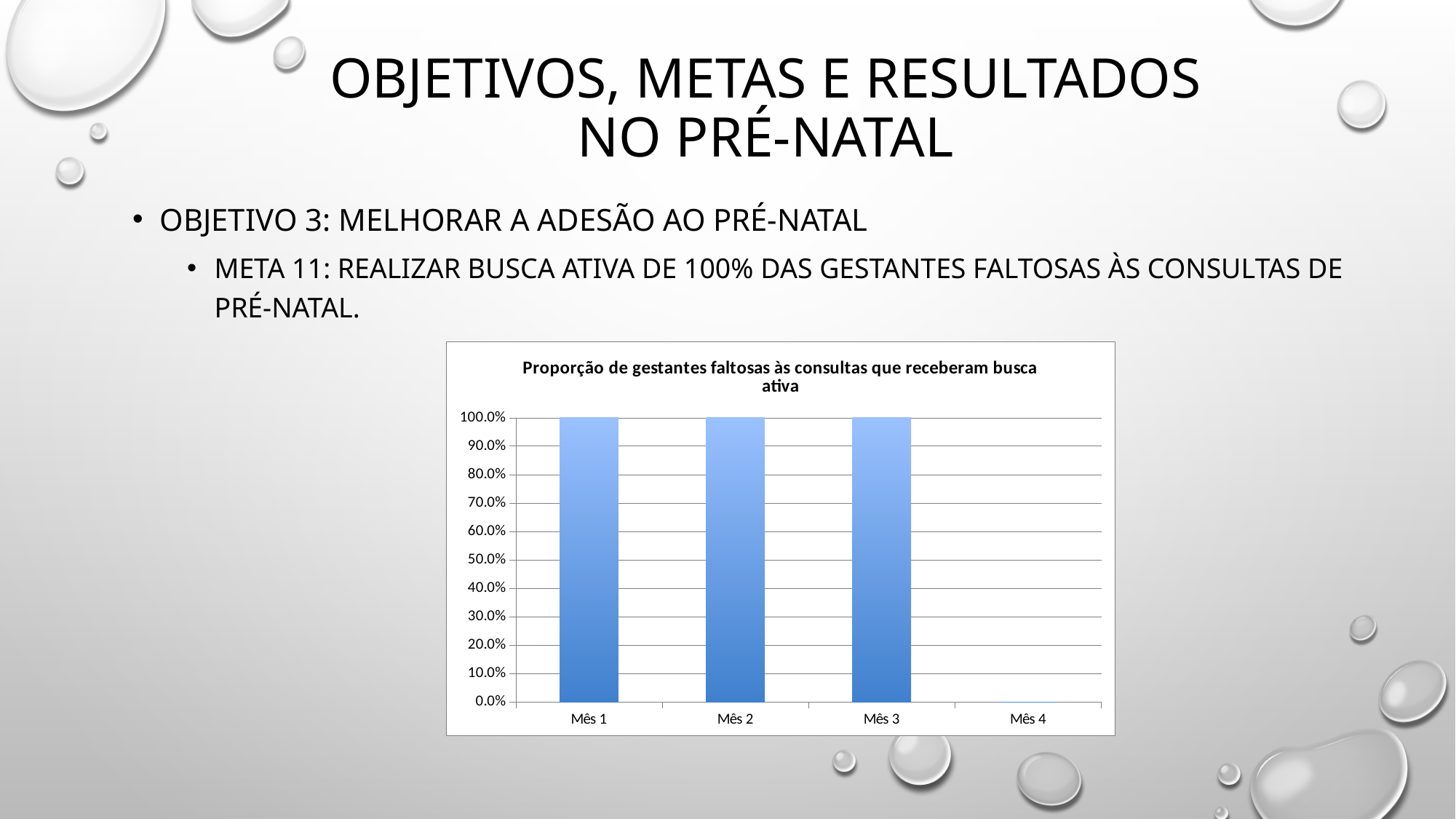
Which is larger, the value for Mês 2 or the value for Mês 4? Mês 2 What is the value for Mês 2? 100.0% What is the value for Mês 3? 100.0% What is the difference between the value for Mês 1 and the value for Mês 4? 100.0% How many months (categories) are shown on the x axis of the chart? 4 What is the value for Mês 4? 0.0% Does the value rise or fall from Mês 3 to Mês 4? fall What is the title of the chart? Proporção de gestantes faltosas às consultas que receberam busca ativa Is the value for Mês 3 greater or less than 50.0%? greater What is the value for Mês 1? 100.0% What type of chart is shown on the slide? bar chart Which month has the lowest value? Mês 4